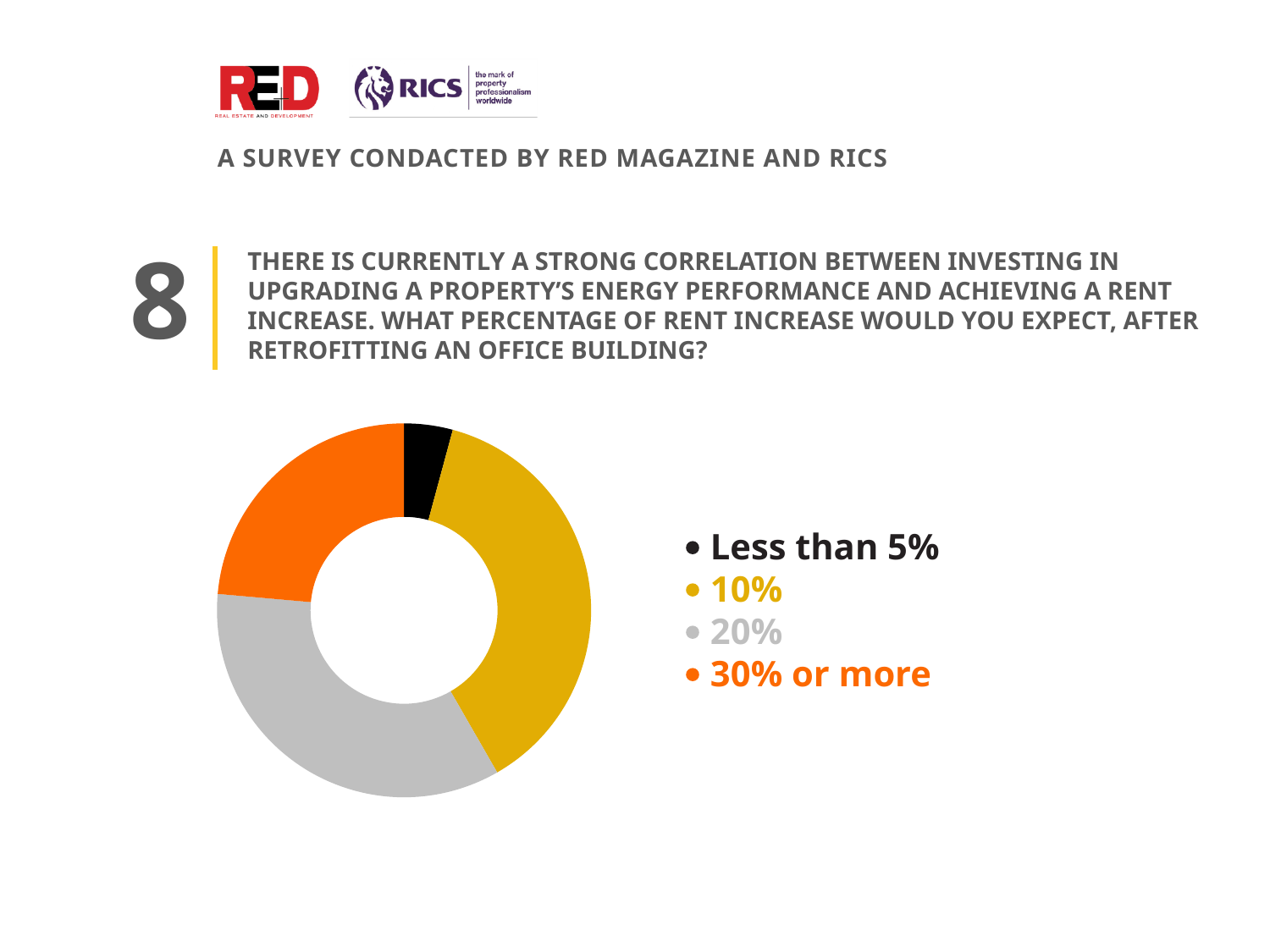
How many categories does the donut chart show? 4 What colour represents the "30% or more" category in the donut chart? Orange Which slice is larger in the donut chart: "30% or more" or "Less than 5%"? 30% or more What kind of chart is shown on the slide? Donut (pie) chart Which slice is larger in the donut chart: "20%" or "30% or more"? 20% Which slice is larger in the donut chart: "10%" or "Less than 5%"? 10% Which category has the smallest slice in the donut chart? Less than 5% What colour represents the "20%" category in the donut chart? Grey